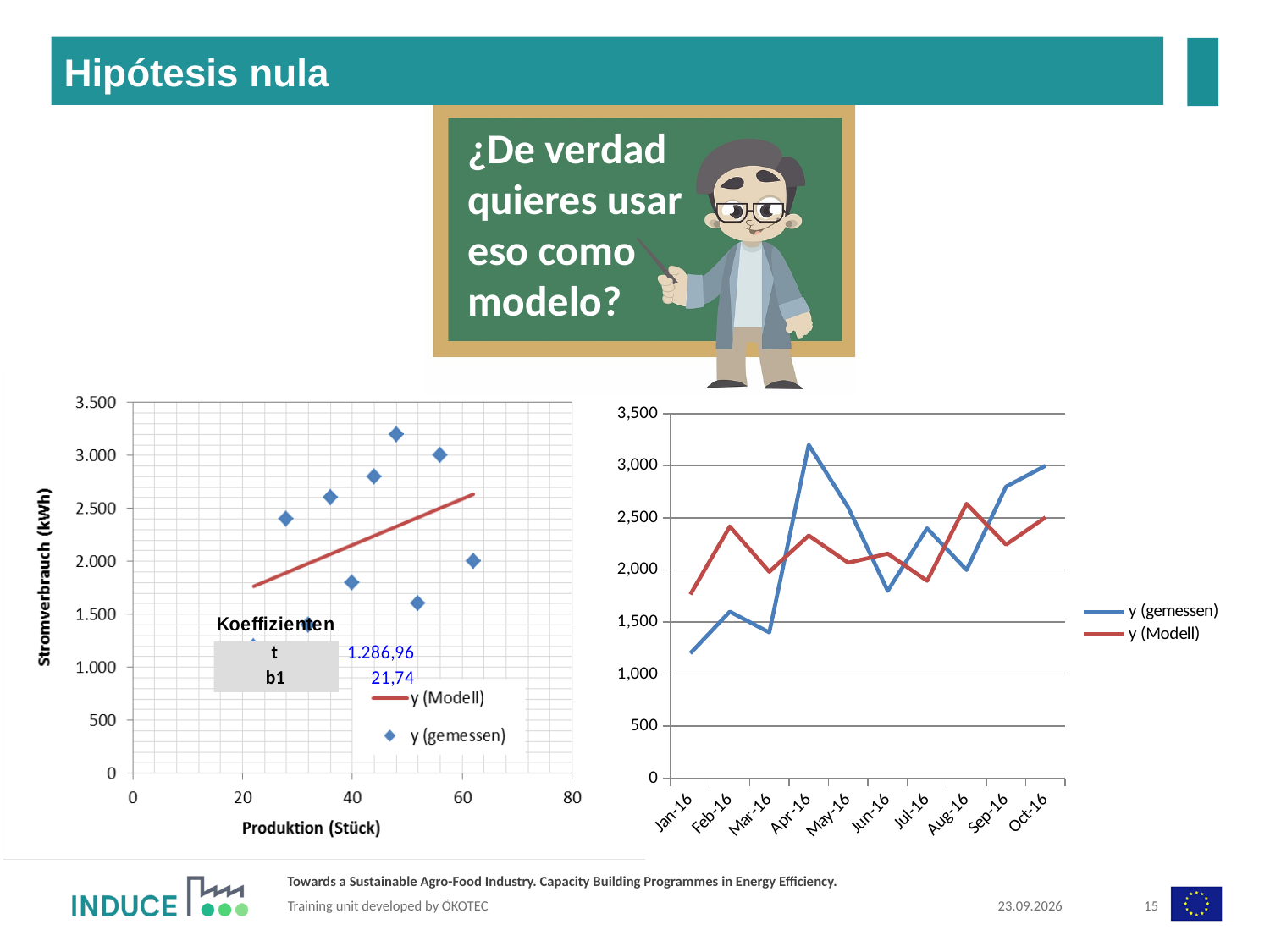
How many months are shown on the x axis of the right-hand chart? 10 What kind of chart is the right-hand chart on the slide? line chart In the right-hand chart, in which month is y (gemessen) lowest? Jan-16 In the right-hand chart, in which month is y (Modell) highest? Aug-16 What is the x-axis title of the left-hand chart? Produktion (Stück) How many series does the legend of the right-hand chart list? 2 In the right-hand chart, in which month is y (gemessen) highest? Apr-16 In the right-hand chart, is the value of y (gemessen) for Apr-16 greater or less than 3,000? greater In the right-hand chart, does y (gemessen) rise or fall from Aug-16 to Oct-16? rise What kind of chart is the left-hand chart on the slide? scatter chart In the right-hand chart, is the value of y (gemessen) for Jan-16 greater or less than 1,500? less In the right-hand chart, which series has the larger value in Apr-16, y (gemessen) or y (Modell)? y (gemessen)